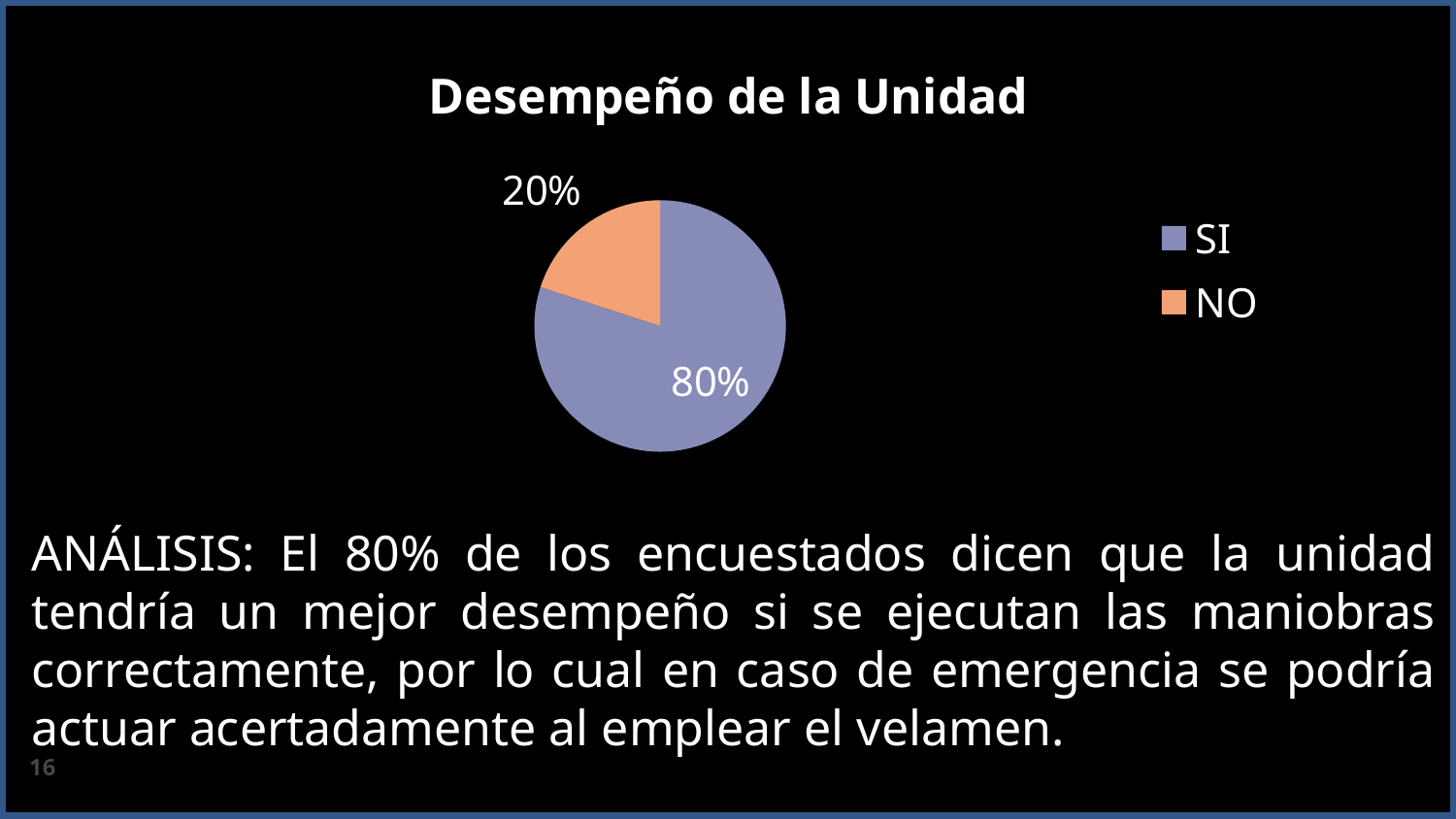
Which category has the smallest slice of the pie? NO Which category has the largest slice of the pie? SI What percentage of the pie is labelled SI? 80% What percentage of the pie is labelled NO? 20% What is the title of the chart? Desempeño de la Unidad How many entries does the legend list? 2 What is the difference in percentage points between the SI slice and the NO slice? 60 What share of the pie does the NO slice represent? 20% Which slice is larger, SI or NO? SI What colour is the SI slice in the pie chart? purple/blue How many slices does the pie chart have? 2 What kind of chart is shown on the slide? pie chart